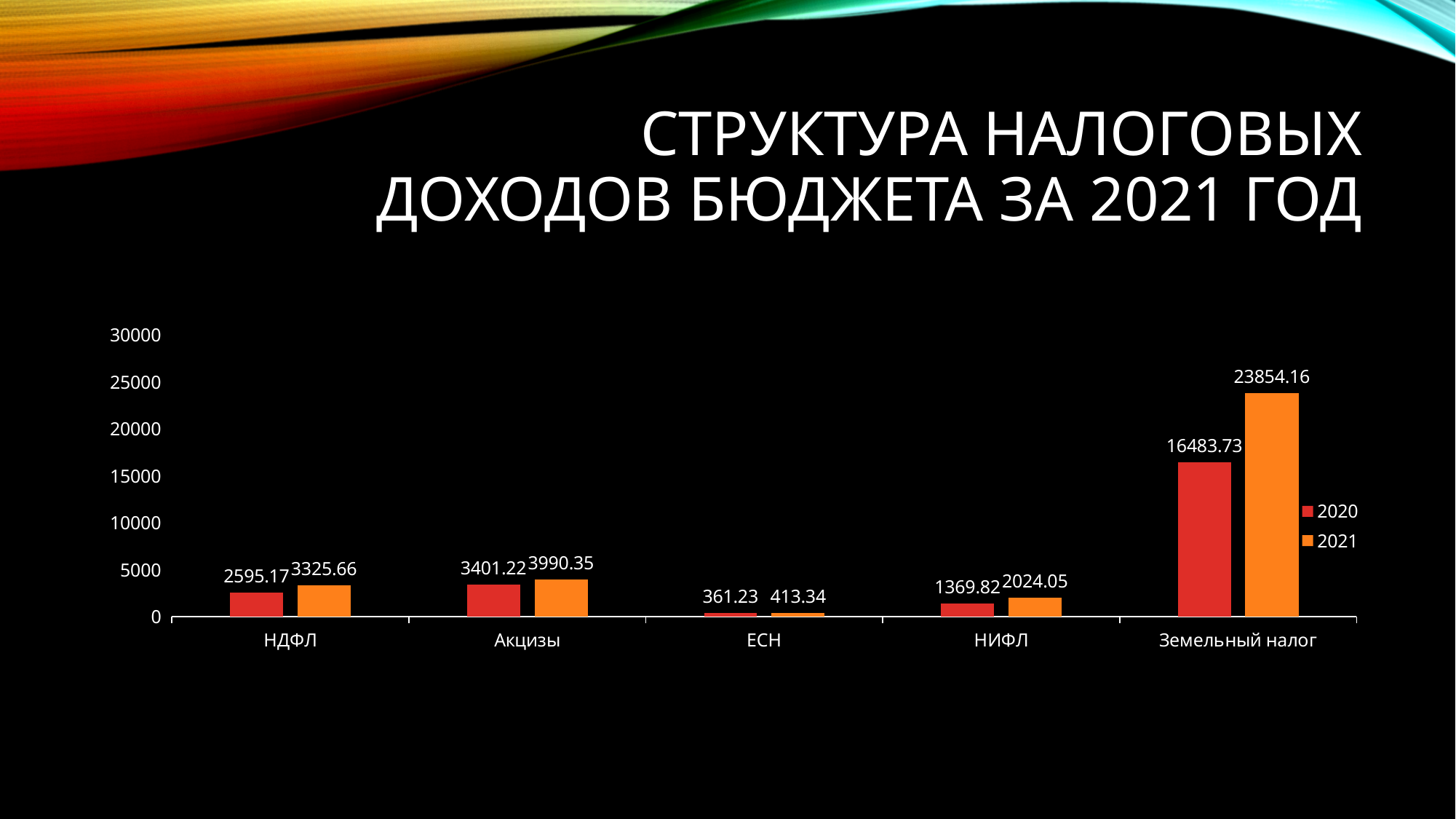
Which is larger for Акцизы: the 2020 value or the 2021 value? 2021 What is the 2021 value for Земельный налог? 23854.16 What is the difference between the 2021 and 2020 values for НИФЛ? 654.23 What is the 2021 value for ЕСН? 413.34 Which category has the lowest 2021 value? ЕСН What is the difference between the 2021 and 2020 values for Земельный налог? 7370.43 What kind of chart is shown on the slide? bar chart What is the 2020 value for НДФЛ? 2595.17 Is the 2020 value for Земельный налог greater or less than 15000? greater Which category has the highest 2020 value? Земельный налог How many categories are shown on the x axis? 5 How many series does the legend list? 2